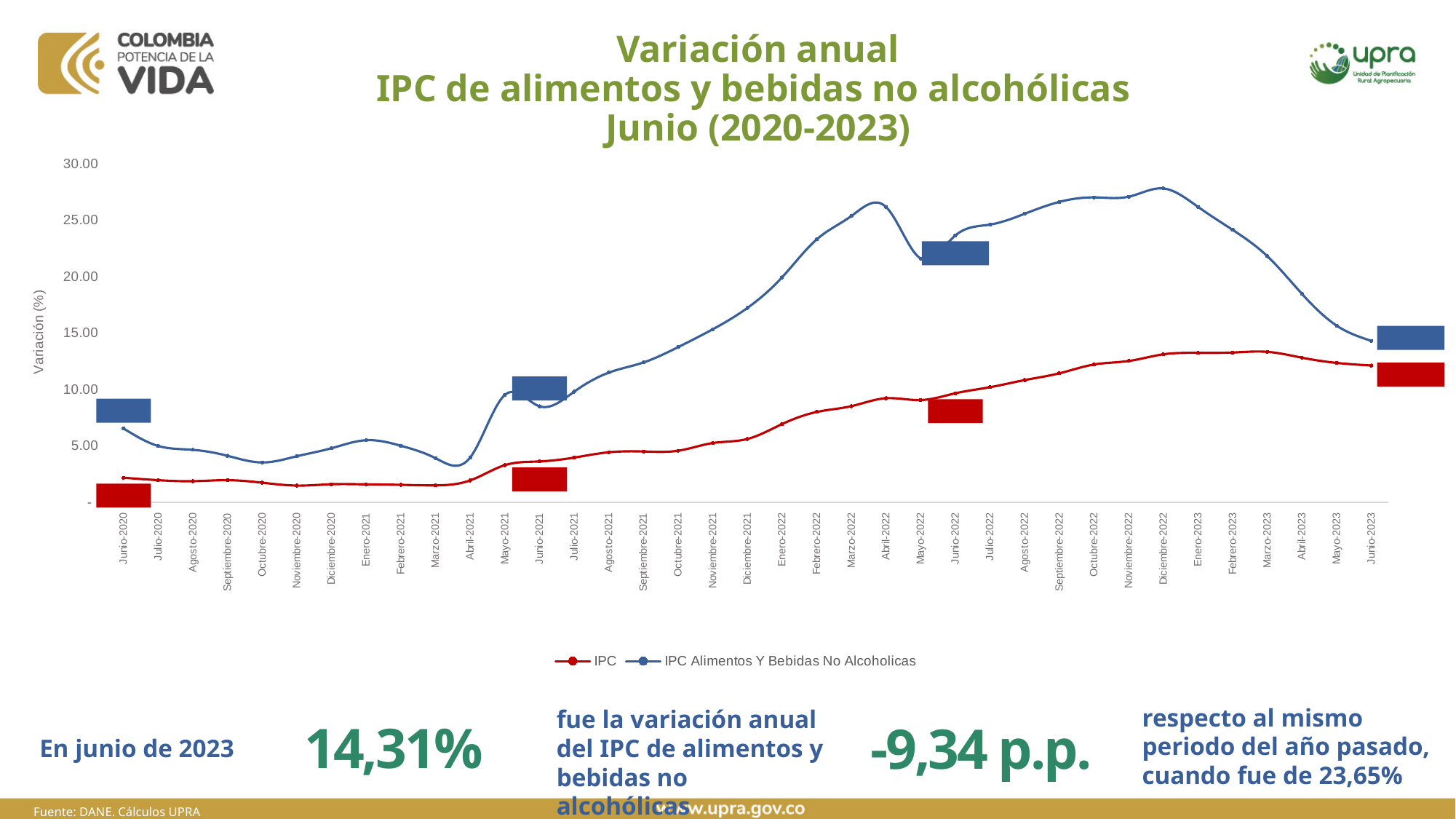
By how many percentage points did the annual variation of the IPC de alimentos y bebidas no alcohólicas change in June 2023 compared with June 2022? -9,34 p.p. According to the slide, what was the annual variation of the IPC de alimentos y bebidas no alcohólicas in June 2023? 14,31% What kind of chart is shown on the slide? line chart Is the value of the IPC Alimentos Y Bebidas No Alcoholicas series for Abril-2022 greater or less than 25.00? greater Does the IPC Alimentos Y Bebidas No Alcoholicas series rise or fall from Diciembre-2022 to Junio-2023? fall At Abril-2022, which series has the larger value, IPC or IPC Alimentos Y Bebidas No Alcoholicas? IPC Alimentos Y Bebidas No Alcoholicas How many monthly points are plotted along the x axis, from Junio-2020 to Junio-2023? 37 Is the value of the IPC series for Junio-2020 greater or less than 5.00? less What is the label of the vertical axis? Variación (%) According to the slide, what was the annual variation of the IPC de alimentos y bebidas no alcohólicas in June 2022? 23,65% Is the value of the IPC series for Marzo-2023 greater or less than 10.00? greater How many series does the legend list? 2